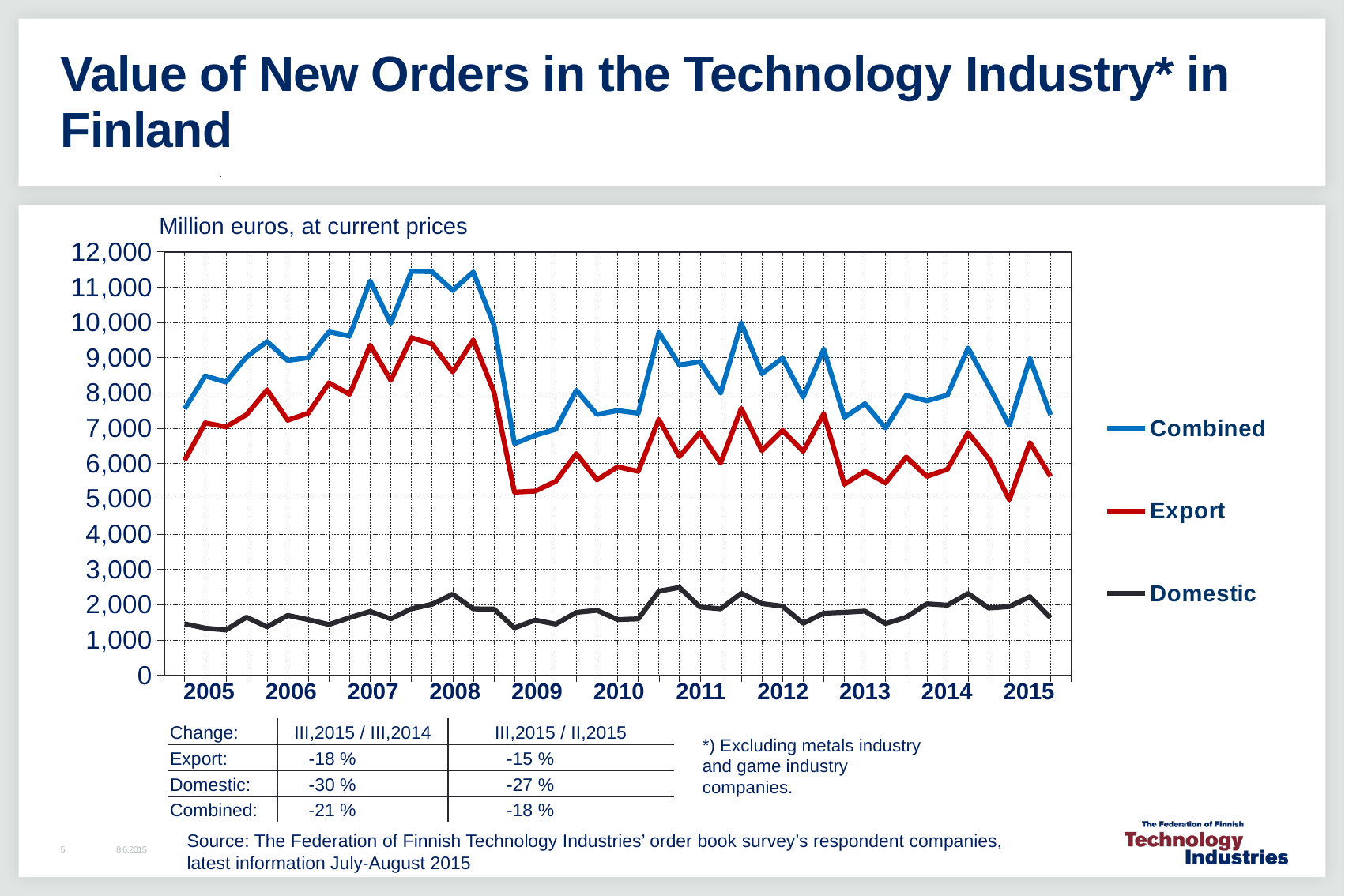
In 2010, which is larger, the Export value or the Domestic value? Export Which series has the lowest values throughout the chart? Domestic Is the peak value of the Combined series in 2007 greater or less than 11,000? greater Which series has the highest values throughout the chart? Combined How many series does the legend list? 3 What unit is stated above the chart's y axis? Million euros, at current prices How many year labels are shown on the x axis? 11 What type of chart is shown on the slide? Line chart Is the lowest value of the Combined series in 2009 greater or less than 7,000? less Is the peak value of the Export series in 2007 greater or less than 9,000? greater Does the Combined series rise or fall between 2008 and 2009? Fall